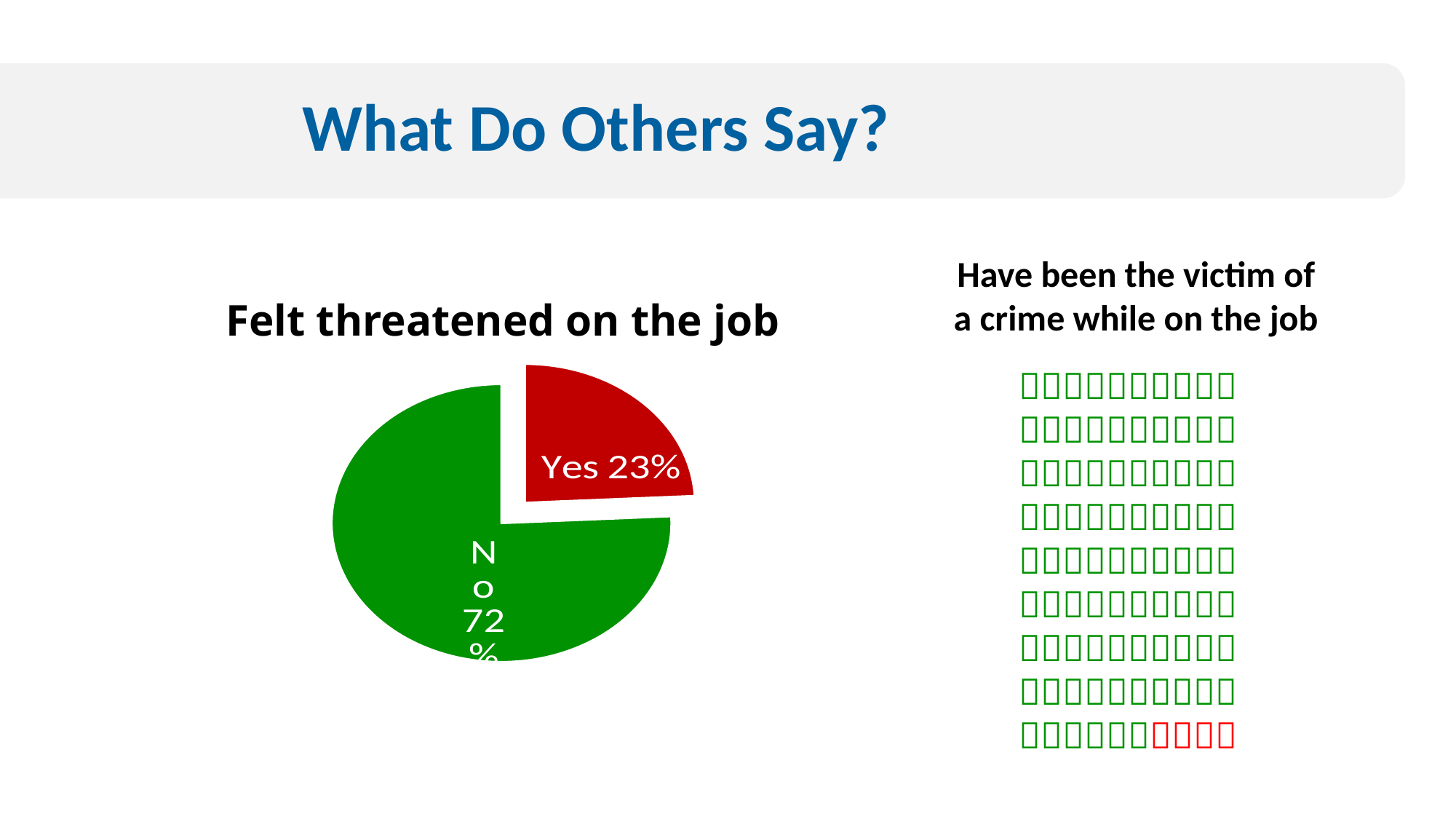
What kind of chart is used for 'Felt threatened on the job'? Pie chart In the pie chart 'Felt threatened on the job', which response has the smallest slice? Yes In the pie chart 'Felt threatened on the job', what percentage answered Yes? 23% In the icon grid 'Have been the victim of a crime while on the job', how many squares are red? 4 In the pie chart 'Felt threatened on the job', which is larger, the Yes slice or the No slice? No How many slices does the pie chart 'Felt threatened on the job' have? 2 In the pie chart 'Felt threatened on the job', which response has the largest slice? No What is the title of the pie chart on the left of the slide? Felt threatened on the job In the pie chart 'Felt threatened on the job', what percentage answered No? 72% In the pie chart 'Felt threatened on the job', what colour is the Yes slice? Red In the pie chart 'Felt threatened on the job', what is the difference between the No and Yes percentages? 49%